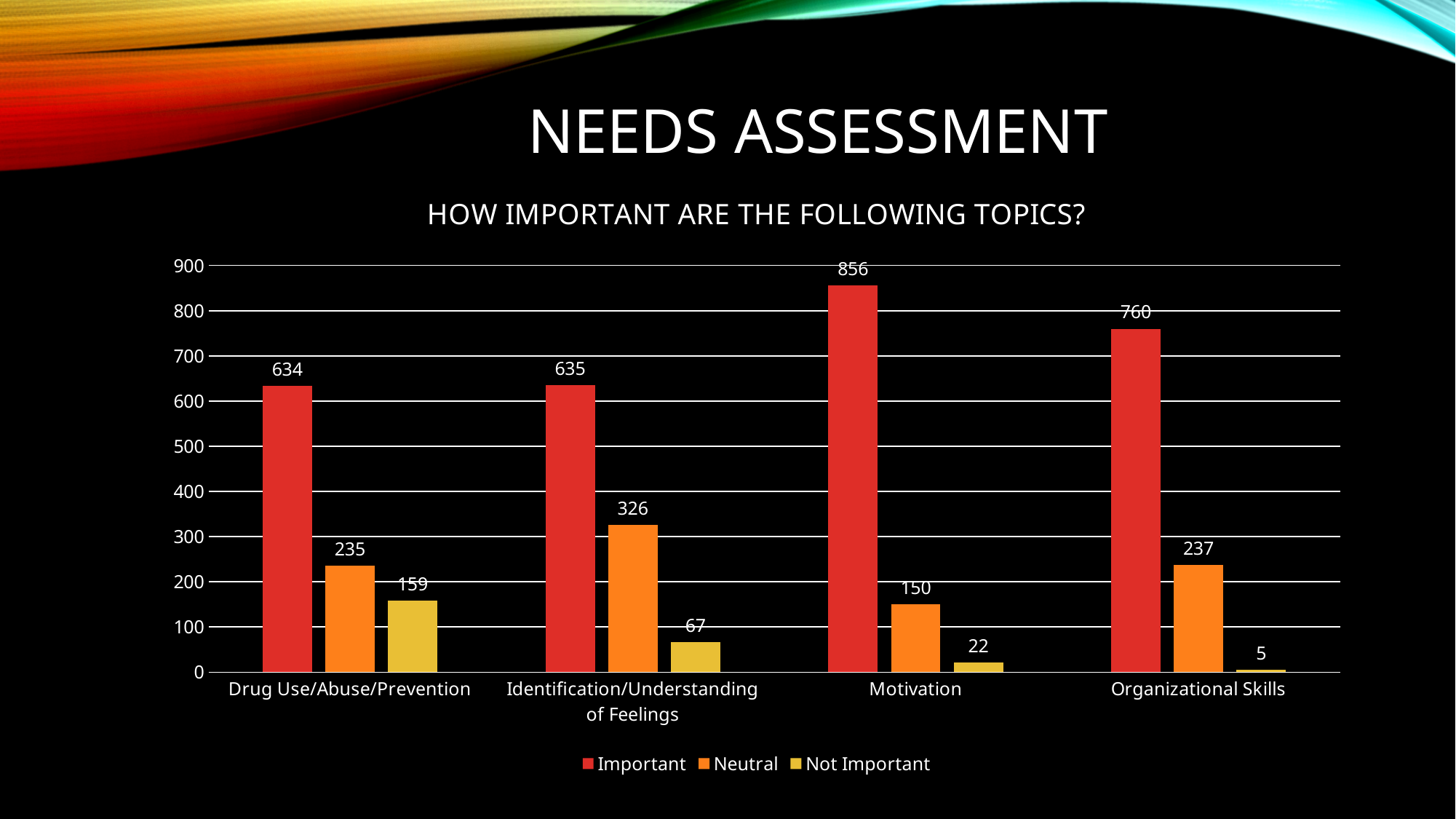
What is the 'Important' value for Motivation? 856 What is the 'Neutral' value for Identification/Understanding of Feelings? 326 How many topics are shown on the x axis? 4 Which is larger: the 'Neutral' value for Drug Use/Abuse/Prevention or the 'Neutral' value for Identification/Understanding of Feelings? Identification/Understanding of Feelings Which topic has the lowest 'Not Important' value? Organizational Skills What is the 'Not Important' value for Organizational Skills? 5 Is the 'Important' value for Organizational Skills greater or less than 700? greater What is the difference between the 'Important' values for Motivation and Organizational Skills? 96 How many series does the legend list? 3 What is the title of the chart? How important are the following topics? What kind of chart is shown? Bar chart Which topic has the highest 'Important' value? Motivation